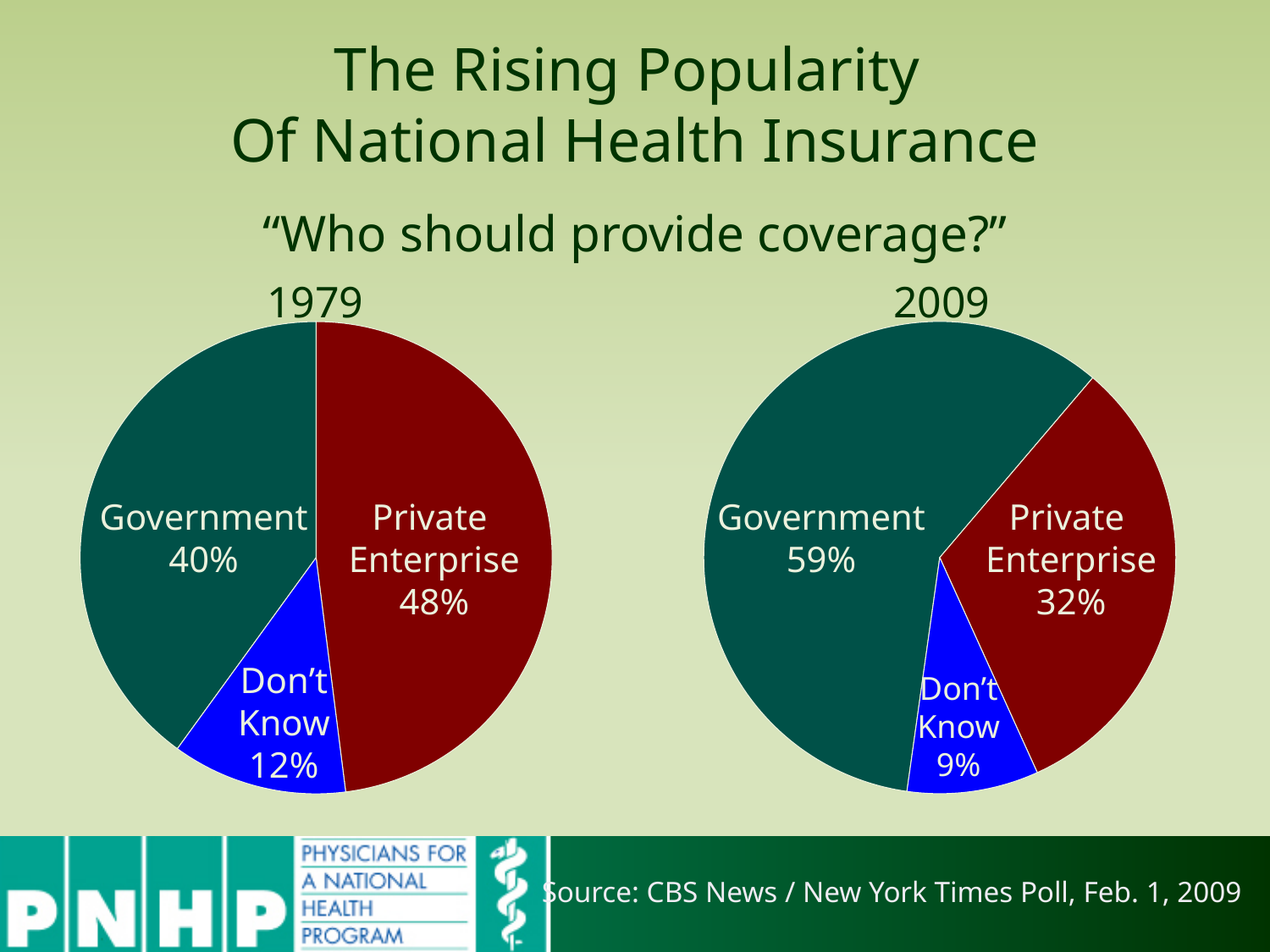
In the 1979 pie chart, what is the difference between the Private Enterprise share and the Don't Know share? 36% What type of chart is used to show the 1979 data? Pie chart In the 1979 pie chart, what percentage is shown for Government? 40% How many slices does the 2009 pie chart have? 3 In the 2009 pie chart, what percentage is shown for Private Enterprise? 32% In the 1979 pie chart, which is larger: Government or Private Enterprise? Private Enterprise In the 2009 pie chart, which category has the largest share? Government What is the difference between the Government share in 2009 and the Government share in 1979? 19% In the 2009 pie chart, what colour is the Don't Know slice? Blue In the 2009 pie chart, which category has the smallest share? Don't Know In the 1979 pie chart, which category has the largest share? Private Enterprise In the 2009 pie chart, what percentage is shown for Don't Know? 9%